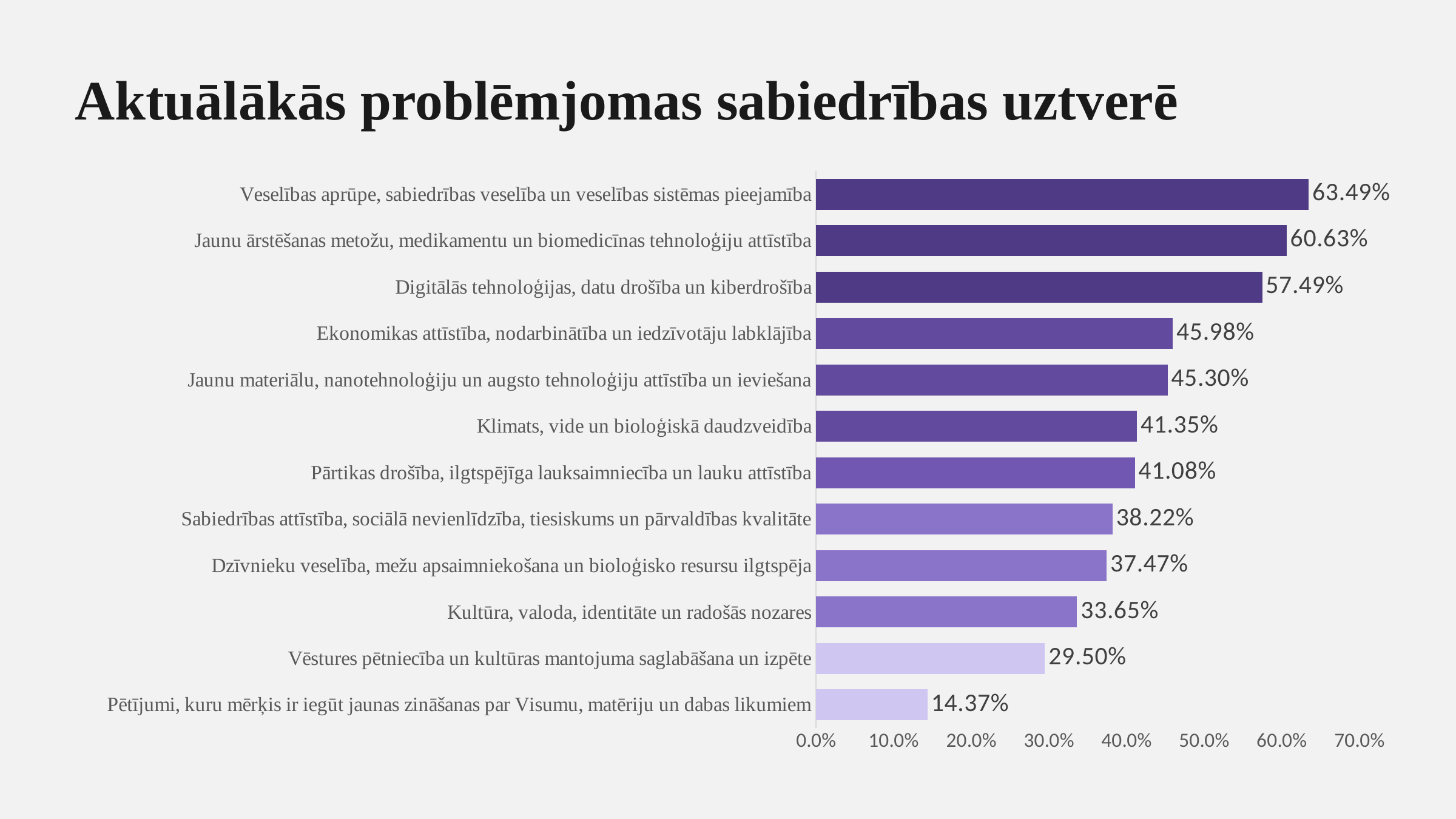
What is the value for "Klimats, vide un bioloģiskā daudzveidība"? 41.35% Which is larger: the value for "Ekonomikas attīstība, nodarbinātība un iedzīvotāju labklājība" or for "Sabiedrības attīstība, sociālā nevienlīdzība, tiesiskums un pārvaldības kvalitāte"? Ekonomikas attīstība, nodarbinātība un iedzīvotāju labklājība Which category has the highest value? Veselības aprūpe, sabiedrības veselība un veselības sistēmas pieejamība What is the difference between the values for "Vēstures pētniecība un kultūras mantojuma saglabāšana un izpēte" and "Pētījumi, kuru mērķis ir iegūt jaunas zināšanas par Visumu, matēriju un dabas likumiem"? 15.13% What is the difference between the values for "Veselības aprūpe, sabiedrības veselība un veselības sistēmas pieejamība" and "Jaunu ārstēšanas metožu, medikamentu un biomedicīnas tehnoloģiju attīstība"? 2.86% What is the value for "Digitālās tehnoloģijas, datu drošība un kiberdrošība"? 57.49% What is the value for "Kultūra, valoda, identitāte un radošās nozares"? 33.65% Which category has the lowest value? Pētījumi, kuru mērķis ir iegūt jaunas zināšanas par Visumu, matēriju un dabas likumiem How many categories are shown in the chart? 12 Is the value for "Dzīvnieku veselība, mežu apsaimniekošana un bioloģisko resursu ilgtspēja" greater or less than 40.0%? less What kind of chart is shown on the slide? bar chart What is the title of the slide? Aktuālākās problēmjomas sabiedrības uztverē